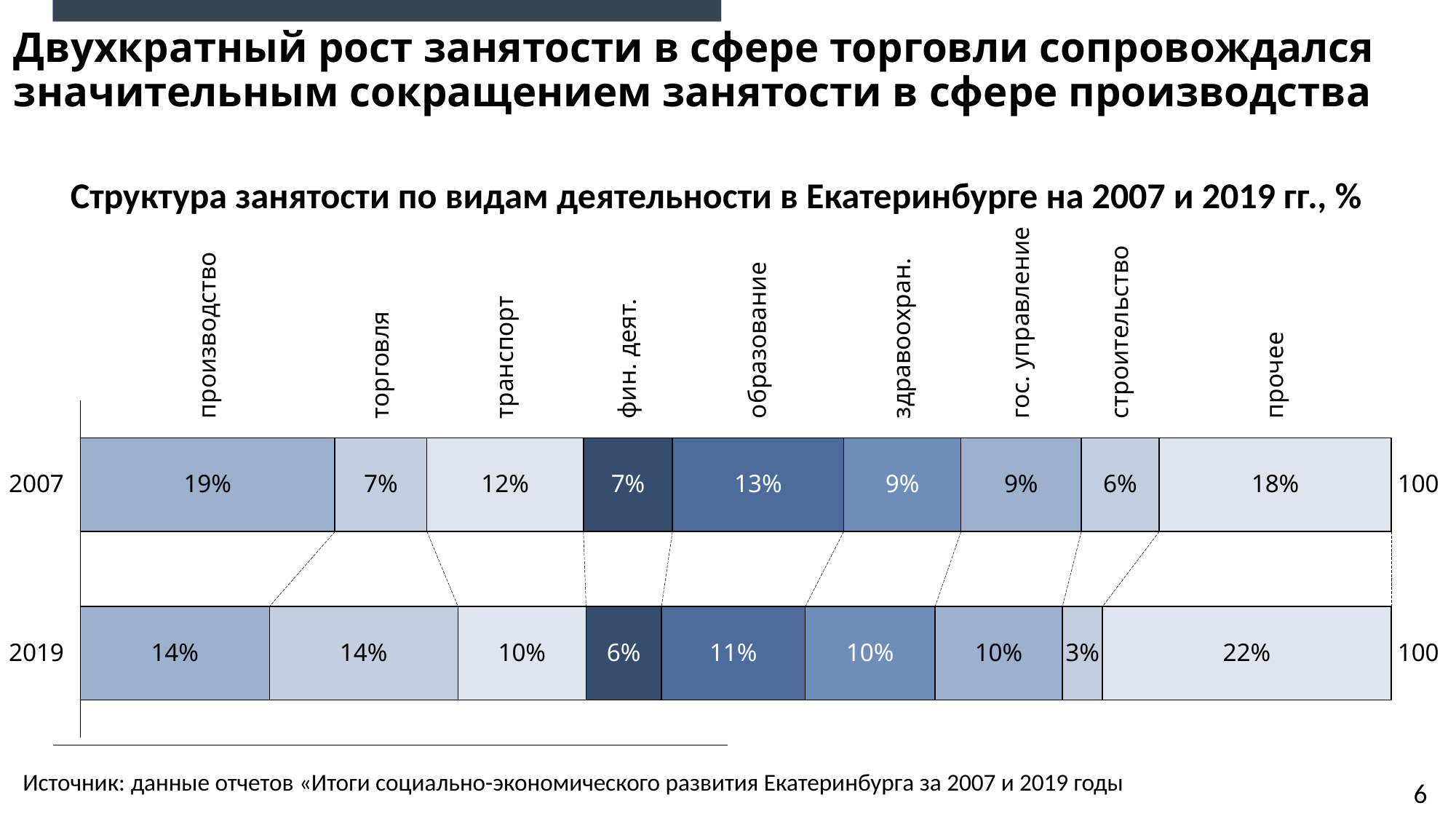
Какой тип диаграммы показан на слайде? столбчатая диаграмма с накоплением (горизонтальная) Какова доля торговли в структуре занятости в 2019 году? 14% Сколько видов деятельности показано в каждой полосе диаграммы? 9 Какой вид деятельности имеет наибольшую долю в 2007 году? производство Какова доля строительства в 2019 году? 3% На сколько процентных пунктов выросла доля торговли с 2007 по 2019 год? 7 Как называется диаграмма на слайде? Структура занятости по видам деятельности в Екатеринбурге на 2007 и 2019 гг., % Что больше: доля образования в 2007 году или доля образования в 2019 году? доля образования в 2007 году На сколько процентных пунктов доля производства в 2019 году меньше, чем в 2007 году? 5 Какой вид деятельности имеет наименьшую долю в 2019 году? строительство Какова доля производства в структуре занятости в 2007 году? 19% Чему равна сумма всех сегментов полосы 2019 года? 100